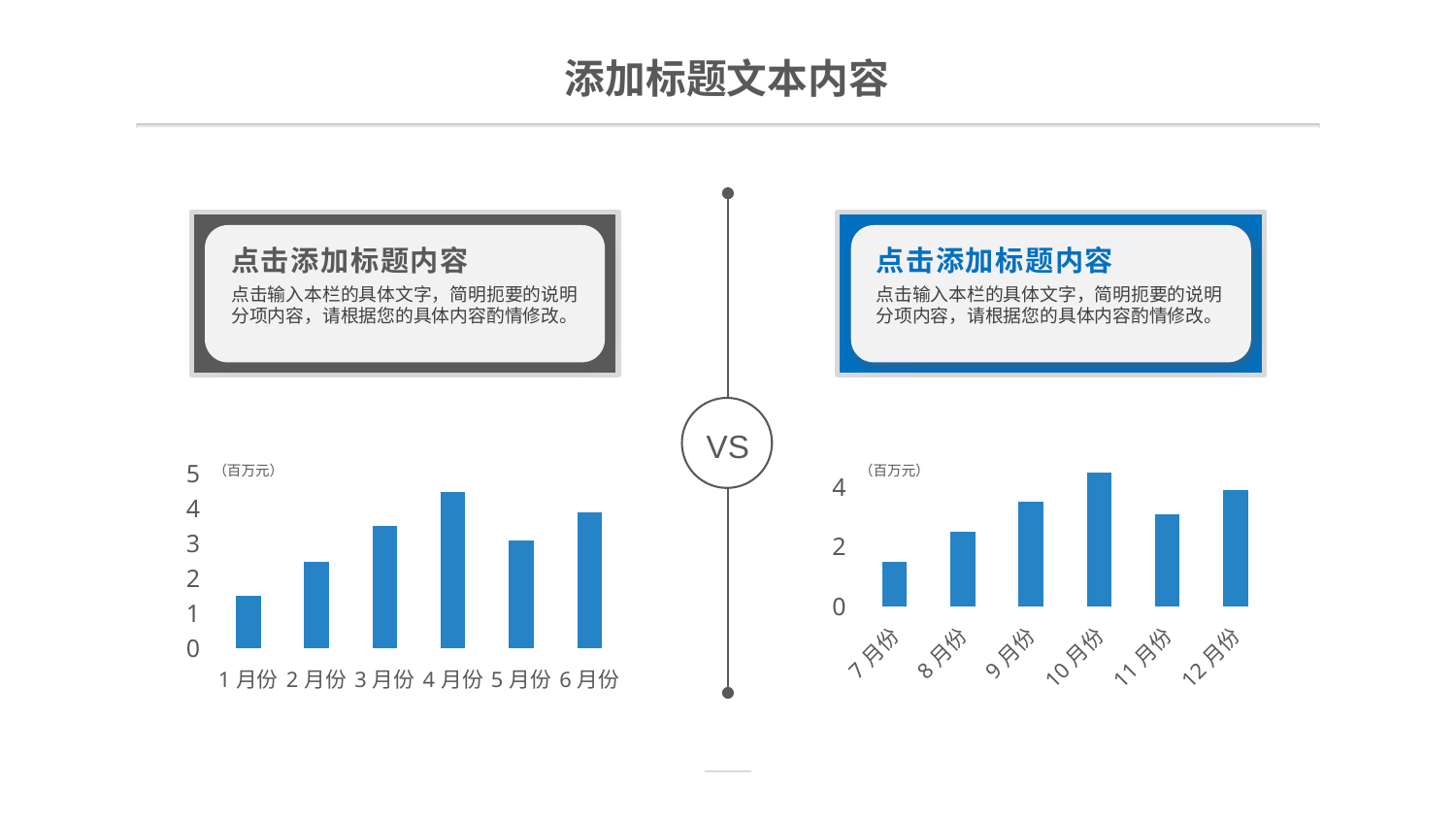
In the left chart (1月份 to 6月份), which month has the lowest bar? 1月份 How many categories does the right chart (7月份 to 12月份) show? 6 What kind of chart is the left chart (1月份 to 6月份)? bar chart In the right chart (7月份 to 12月份), which month has the lowest bar? 7月份 In the right chart (7月份 to 12月份), which month has the highest bar? 10月份 How many categories does the left chart (1月份 to 6月份) show? 6 In the left chart (1月份 to 6月份), is the value for 4月份 greater or less than 4? greater In the left chart (1月份 to 6月份), is the value for 1月份 greater or less than 2? less What unit is shown at the top of the y axis of the right chart (7月份 to 12月份)? 百万元 In the left chart (1月份 to 6月份), which month has the highest bar? 4月份 In the right chart (7月份 to 12月份), is the value for 7月份 greater or less than 2? less In the left chart (1月份 to 6月份), which is larger, the value for 3月份 or the value for 5月份? 3月份